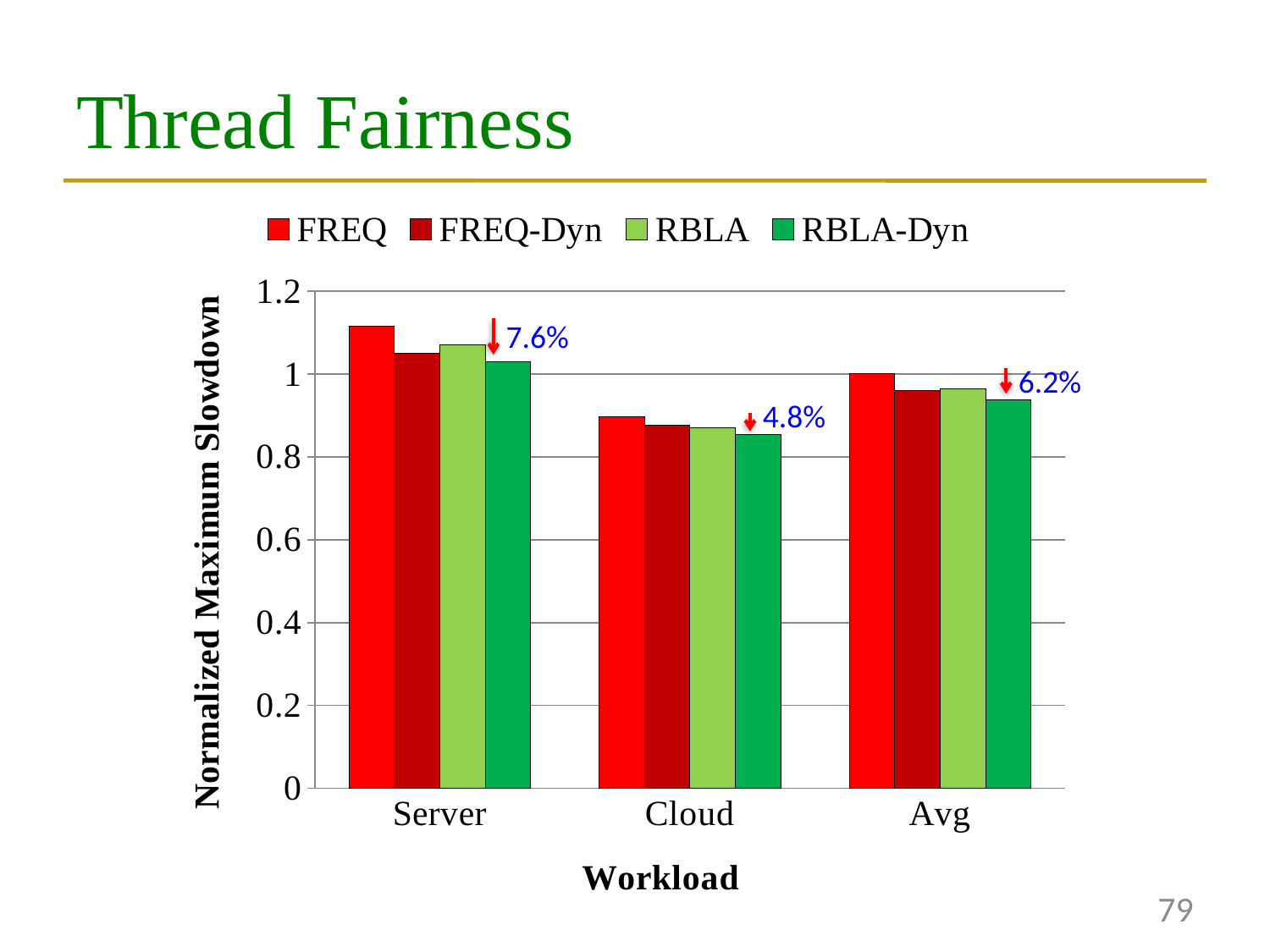
Is the RBLA-Dyn value for Cloud greater or less than 1? less How many workload categories are shown on the x axis? 3 How many series does the legend list? 4 Which workload has the highest FREQ bar? Server What kind of chart is shown on the slide? bar chart Within the Server workload, which is larger, the FREQ bar or the RBLA-Dyn bar? FREQ Is the FREQ-Dyn value for Cloud greater or less than 0.8? greater What percentage reduction is annotated above the Server group? 7.6% Is the FREQ value for Server greater or less than 1? greater Which workload has the lowest RBLA-Dyn bar? Cloud What is the title of the y axis? Normalized Maximum Slowdown Which is larger, the FREQ value for Server or the FREQ value for Cloud? Server